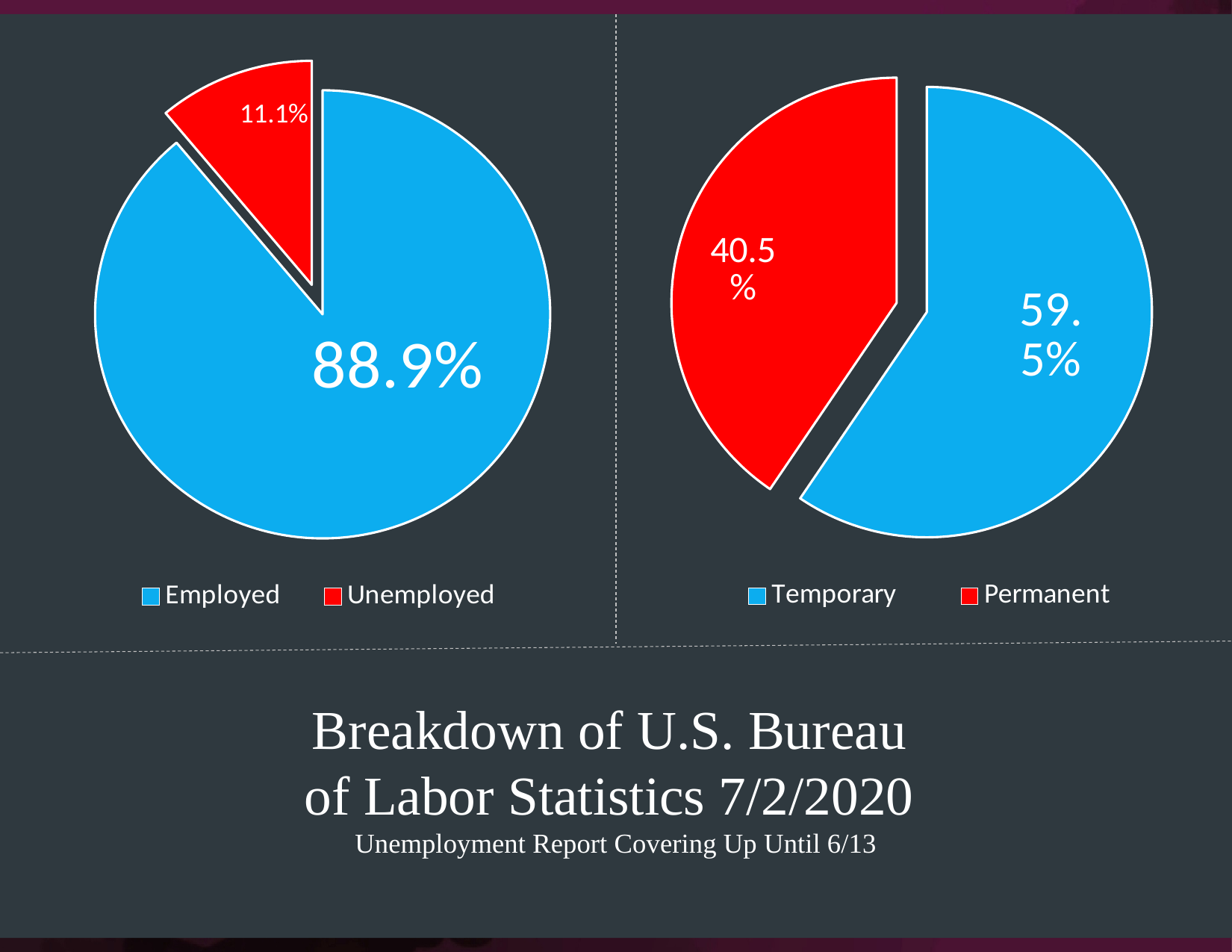
In the left pie chart, which slice is the largest? Employed In the right pie chart, what is the difference in percentage points between Temporary and Permanent? 19 What kind of chart is the left chart? Pie chart In the right pie chart, what share is labelled for Temporary? 59.5% How many slices does the right pie chart have? 2 In the right pie chart, which is larger, Temporary or Permanent? Temporary In the right pie chart, what share is labelled for Permanent? 40.5% In the left pie chart, what is the difference in percentage points between Employed and Unemployed? 77.8 In the left pie chart, what share is labelled for Unemployed? 11.1% In the left pie chart, what share is labelled for Employed? 88.9% How many entries does the legend of the left pie chart list? 2 In the right pie chart, which slice is the smallest? Permanent